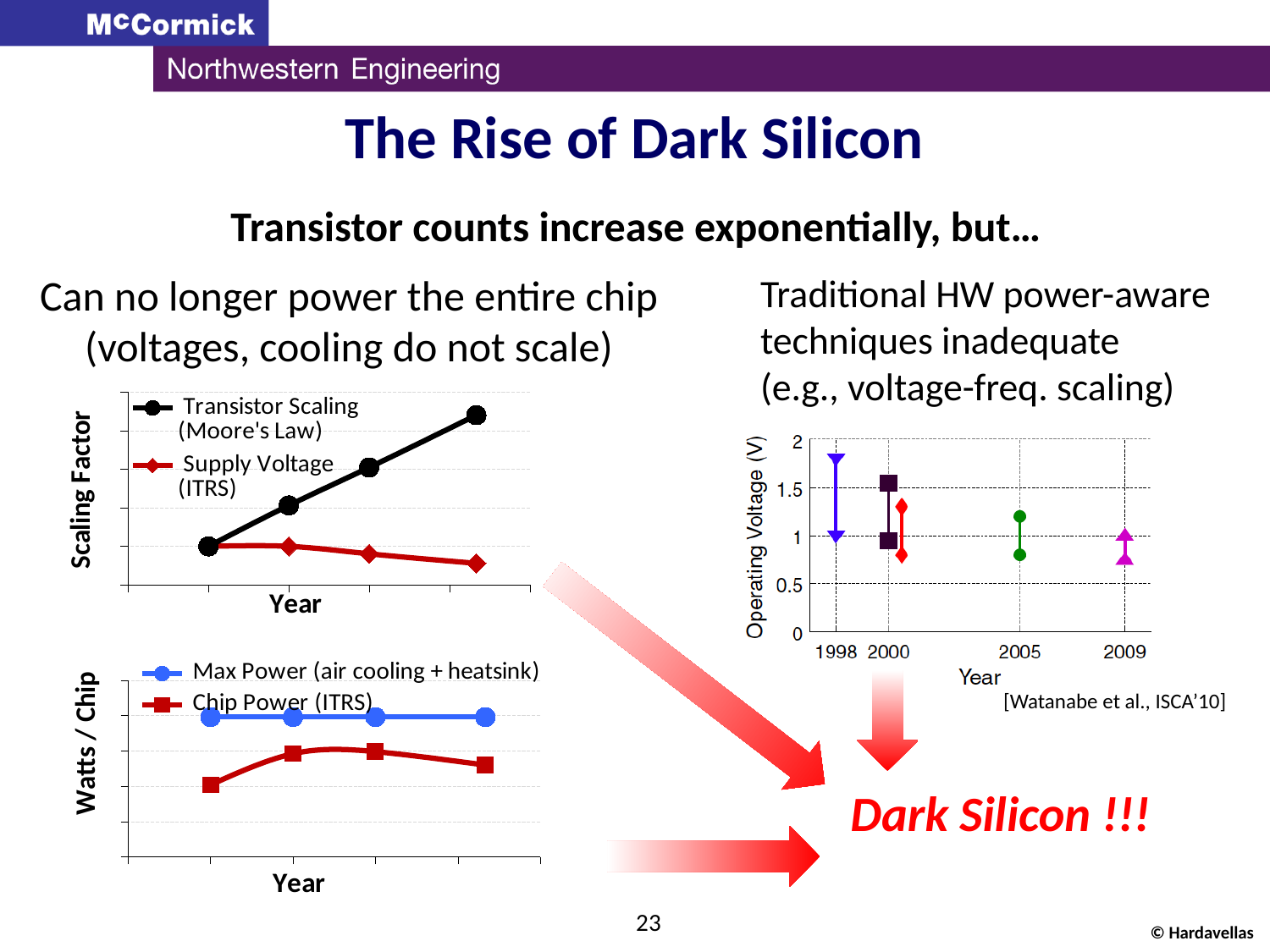
How many series does the legend of the top-left 'Scaling Factor' chart list? 2 How many series does the legend of the bottom-left 'Watts / Chip' chart list? 2 In the right-hand 'Operating Voltage (V)' chart, is the lowest operating voltage shown for 2005 greater or less than 1? less In the top-left 'Scaling Factor' chart, which series is higher at the last year shown: Transistor Scaling (Moore's Law) or Supply Voltage (ITRS)? Transistor Scaling (Moore's Law) How many years are labelled on the x-axis of the right-hand 'Operating Voltage (V)' chart? 4 What kind of chart is the top-left chart with the y-axis labelled 'Scaling Factor'? line chart In the top-left 'Scaling Factor' chart, how many data points does the Transistor Scaling (Moore's Law) series have? 4 In the top-left 'Scaling Factor' chart, does the Supply Voltage (ITRS) series rise or fall along the Year axis? fall In the bottom-left 'Watts / Chip' chart, which series is higher at the first year shown: Max Power (air cooling + heatsink) or Chip Power (ITRS)? Max Power (air cooling + heatsink) In the top-left 'Scaling Factor' chart, does the Transistor Scaling (Moore's Law) series rise or fall along the Year axis? rise In the bottom-left 'Watts / Chip' chart, does the Max Power (air cooling + heatsink) series rise, fall, or stay flat along the Year axis? stay flat In the right-hand 'Operating Voltage (V)' chart, is the highest operating voltage shown for 1998 greater or less than 1.5? greater